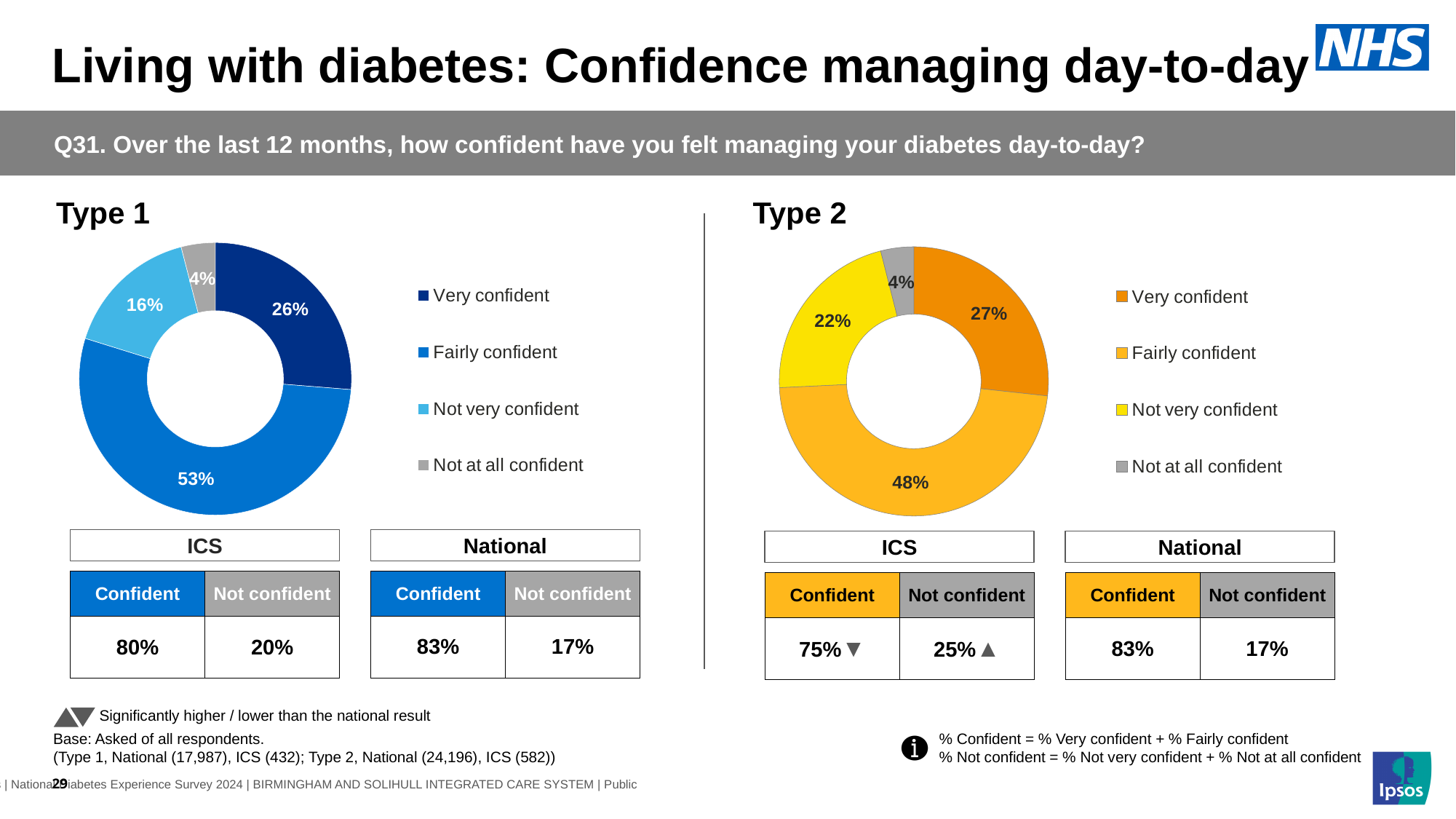
What kind of chart is used for Type 2? Doughnut (pie) chart In the Type 2 chart, what percentage of respondents were not very confident? 22% In the Type 1 chart, what percentage of respondents were fairly confident? 53% In the Type 1 chart, which category has the largest share? Fairly confident In the Type 1 chart, which is larger: Very confident or Not very confident? Very confident In the Type 2 chart, which category has the smallest share? Not at all confident In the Type 2 chart, what is the Very confident share? 27% In the Type 1 chart, what colour is the Not at all confident slice? Grey How many entries does the legend of the Type 2 chart list? 4 In the Type 2 chart, what is the difference between the Fairly confident and Very confident shares? 21 percentage points In the Type 1 chart, what is the combined share of Very confident and Fairly confident? 79% How many categories does the Type 1 chart show? 4